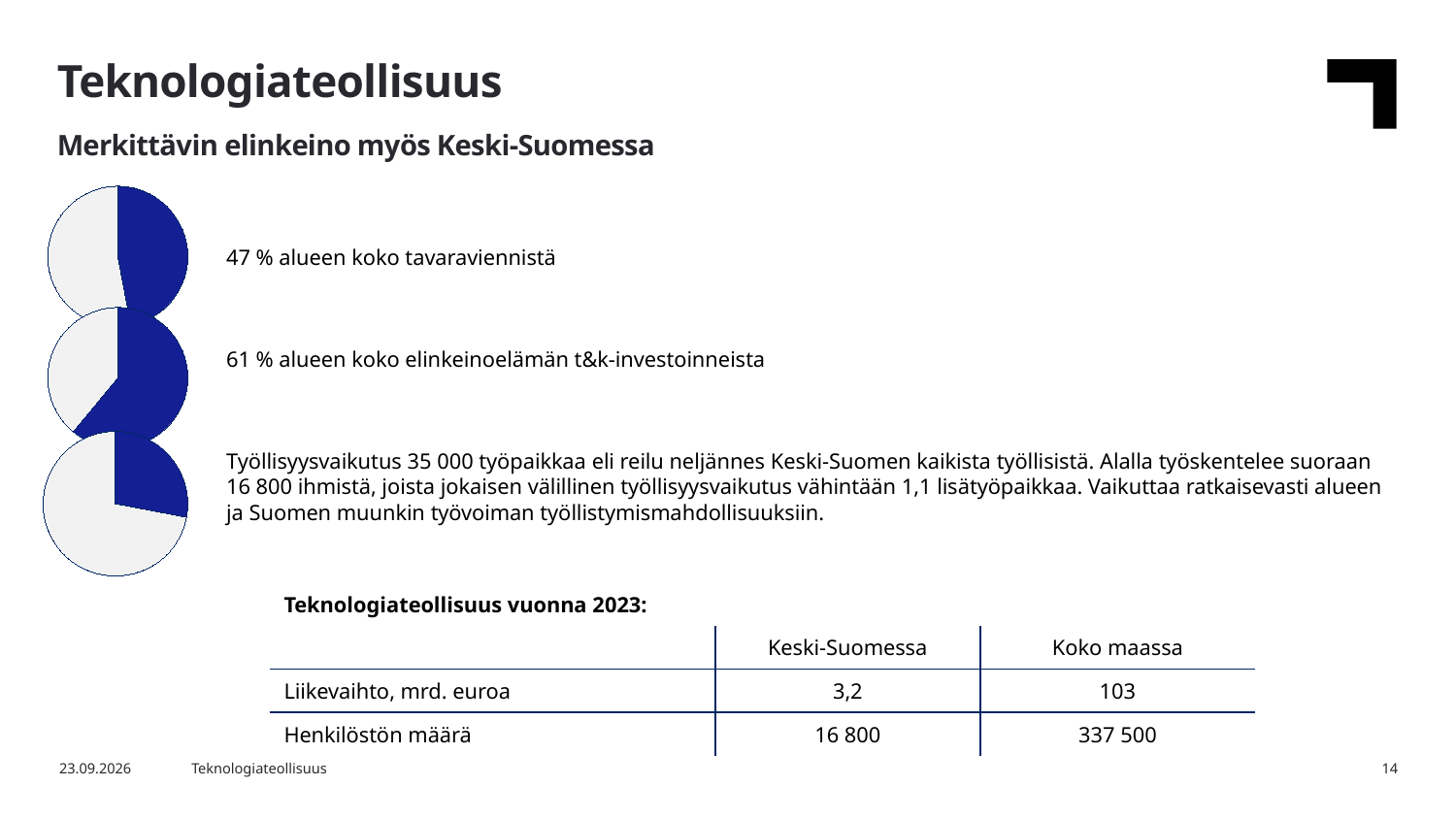
In the middle pie chart, what share of the region's business R&D investments (t&k-investoinnit) does the highlighted slice represent? 61 % What kind of charts are shown on the left side of the slide? Pie charts What is the difference in percentage points between the highlighted shares of the middle pie chart (61 %) and the top pie chart (47 %)? 14 percentage points Which of the three pie charts has the smallest highlighted slice? The bottom one (työllisyysvaikutus) How many slices does each pie chart have? 2 Which of the three pie charts has the largest highlighted slice? The middle one (t&k-investoinnit) How many pie charts are on the slide? 3 Which pie chart has the larger highlighted slice, the top one (tavaravienti) or the middle one (t&k-investoinnit)? The middle one (t&k-investoinnit) In the top pie chart, what share of the region's total goods exports (tavaravienti) does the highlighted slice represent? 47 % What colour is the highlighted slice in the pie charts? Dark blue Is the highlighted slice in the bottom pie chart (työllisyysvaikutus) greater or less than half of the pie? less